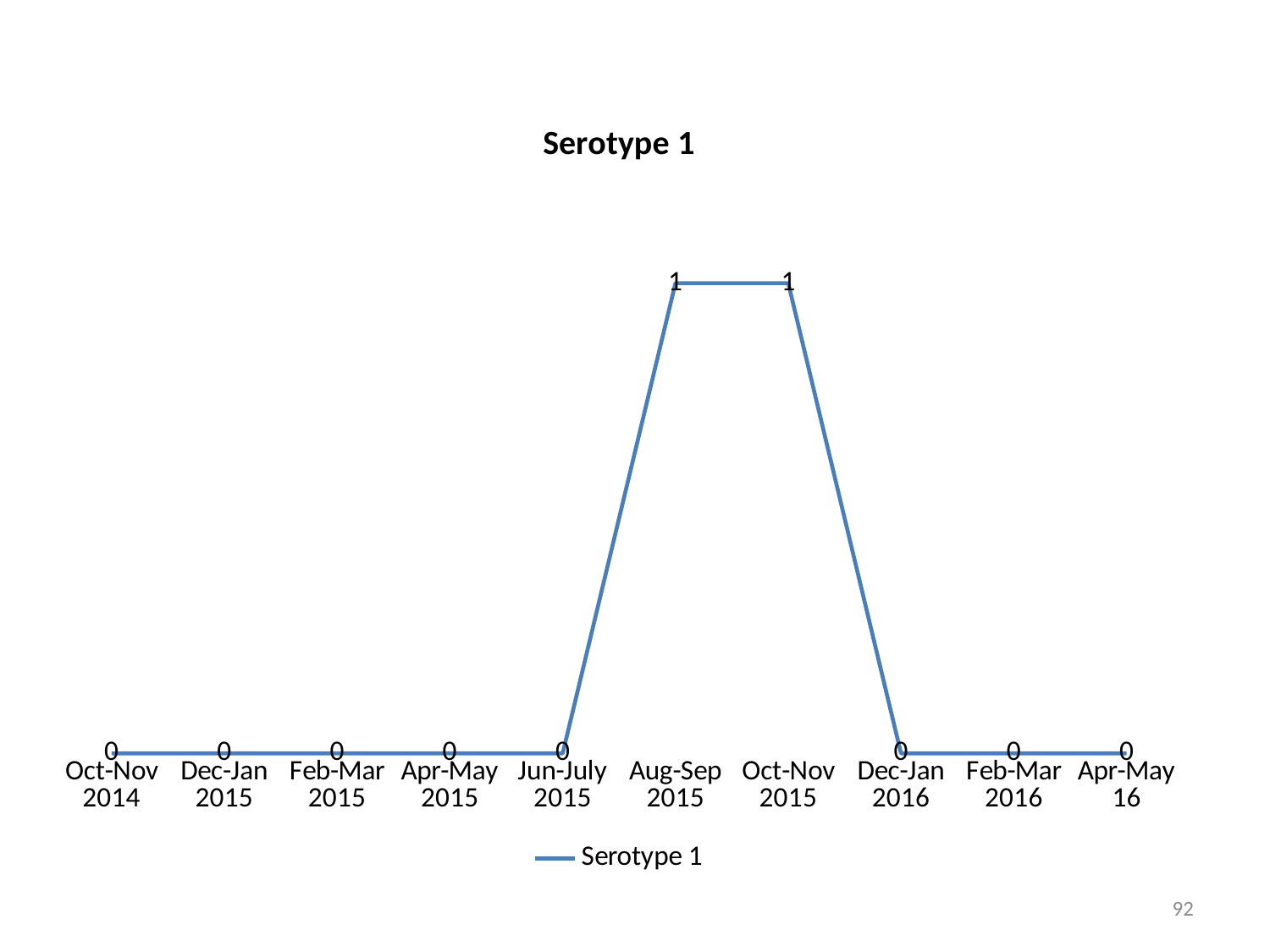
How many time periods are shown on the x axis? 10 What is the value for Apr-May 16? 0 Which periods have the highest value? Aug-Sep 2015 and Oct-Nov 2015 How many series does the legend list? 1 What is the title of the chart? Serotype 1 What is the value for Jun-July 2015? 0 What kind of chart is this? line chart What is the value for Aug-Sep 2015? 1 Which is larger, the value for Aug-Sep 2015 or the value for Feb-Mar 2016? Aug-Sep 2015 Does the value rise or fall between Oct-Nov 2015 and Dec-Jan 2016? fall What is the difference between the values for Oct-Nov 2015 and Dec-Jan 2016? 1 What is the value for Oct-Nov 2015? 1